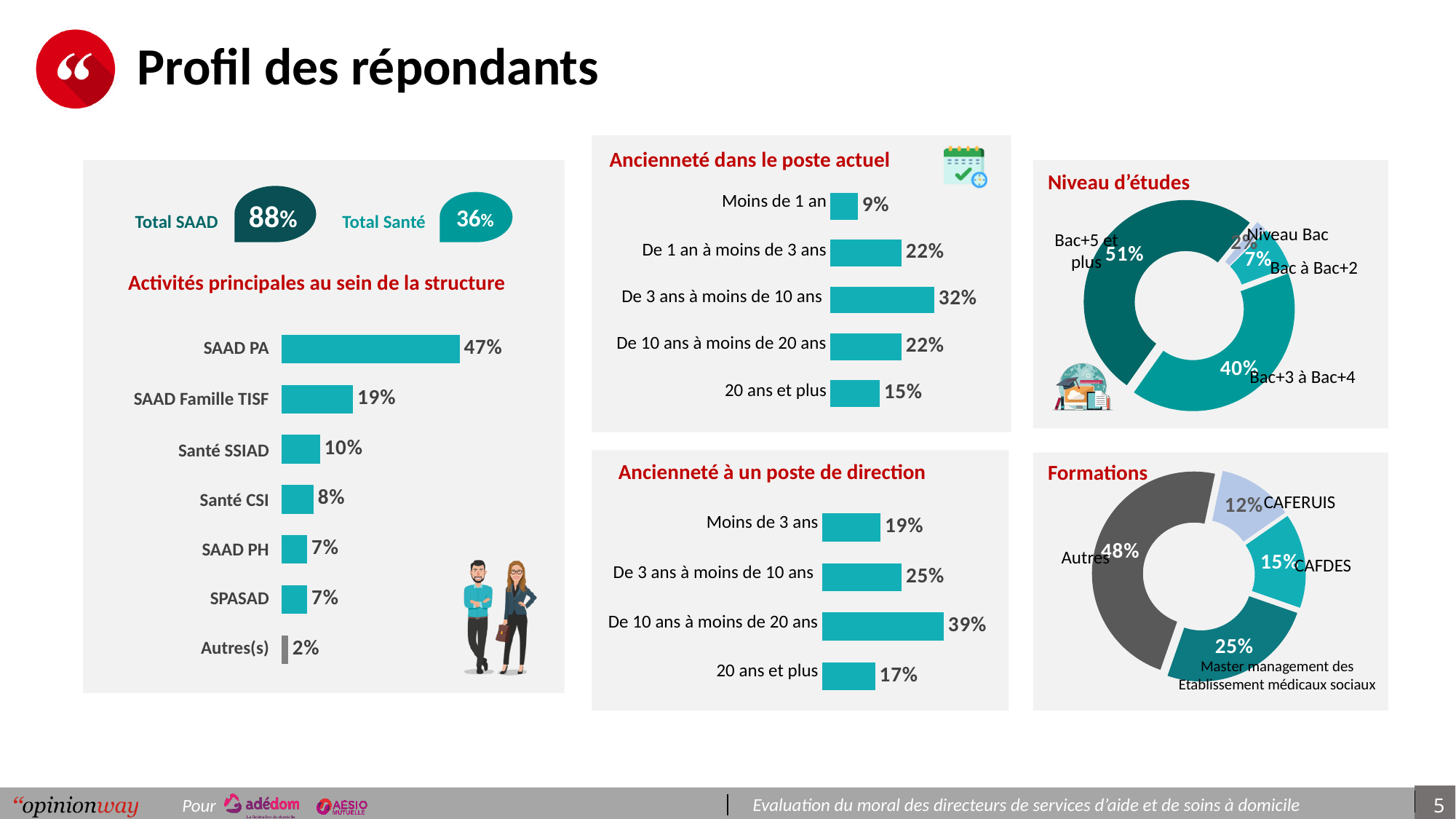
In the 'Formations' chart, which category has the largest share? Autres In the 'Niveau d'études' chart, what share does 'Bac+5 et plus' represent? 51% In the 'Ancienneté dans le poste actuel' chart, which category has the highest value? De 3 ans à moins de 10 ans In the 'Activités principales au sein de la structure' chart, how many categories are shown? 7 In the 'Niveau d'études' chart, what is the value for 'Bac à Bac+2'? 7% What kind of chart is 'Ancienneté à un poste de direction'? Bar chart In the 'Activités principales au sein de la structure' chart, which category has the lowest value? Autres(s) In the 'Ancienneté à un poste de direction' chart, which is larger: 'Moins de 3 ans' or 'De 10 ans à moins de 20 ans'? De 10 ans à moins de 20 ans In the 'Ancienneté à un poste de direction' chart, what is the value for 'De 3 ans à moins de 10 ans'? 25% In the 'Ancienneté dans le poste actuel' chart, what is the value for '20 ans et plus'? 15% In the 'Activités principales au sein de la structure' chart, what is the value for SAAD PA? 47% In the 'Activités principales au sein de la structure' chart, what is the difference between SAAD PA and SAAD Famille TISF? 28%